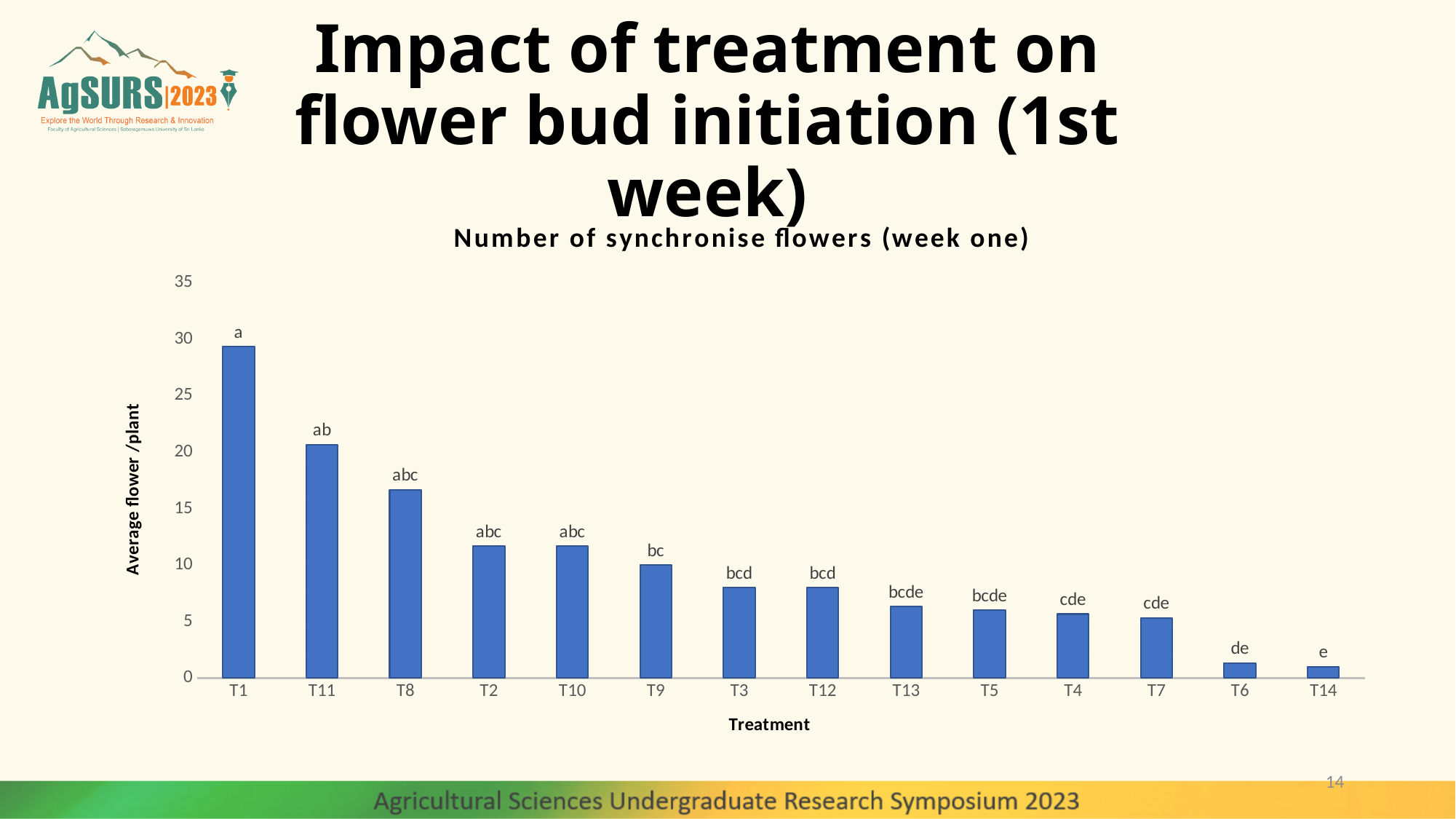
What kind of chart is shown on the slide? bar chart Is the value for T3 greater or less than 10? less Is the value for T6 greater or less than 5? less Do the bar values rise or fall moving from left to right along the x axis? fall Which treatment has the highest average flower per plant? T1 Which has a larger average flower per plant, T8 or T2? T8 How many treatments are shown on the x axis? 14 What is the title of the chart? Number of synchronise flowers (week one) Which has a larger average flower per plant, T1 or T11? T1 Which treatment has the lowest average flower per plant? T14 Is the value for T1 greater or less than 25? greater